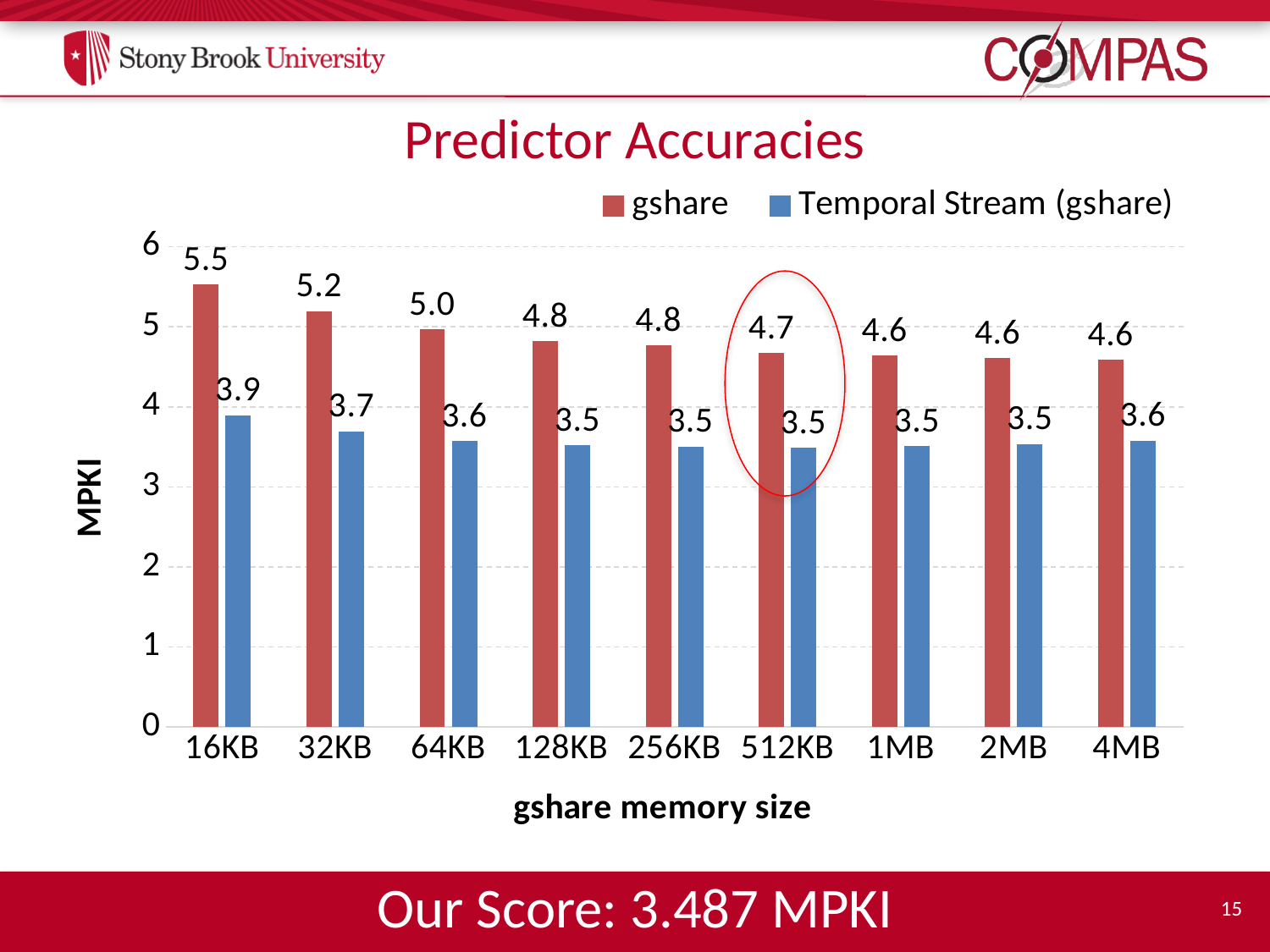
Which memory size has the highest gshare MPKI? 16KB Which memory size has the highest Temporal Stream (gshare) MPKI? 16KB Does the gshare MPKI rise or fall as memory size increases from 16KB to 4MB? fall Is the gshare MPKI value at 64KB greater or less than 4? greater What is the gshare MPKI value at 4MB memory size? 4.6 What is the difference between the gshare and Temporal Stream (gshare) MPKI values at 16KB? 1.6 What is the gshare MPKI value at 16KB memory size? 5.5 What is the Temporal Stream (gshare) MPKI value at 512KB memory size? 3.5 What kind of chart is shown on the slide? bar chart At 32KB, which series has the larger MPKI value, gshare or Temporal Stream (gshare)? gshare How many memory size categories are shown on the x axis? 9 How many series does the legend list? 2